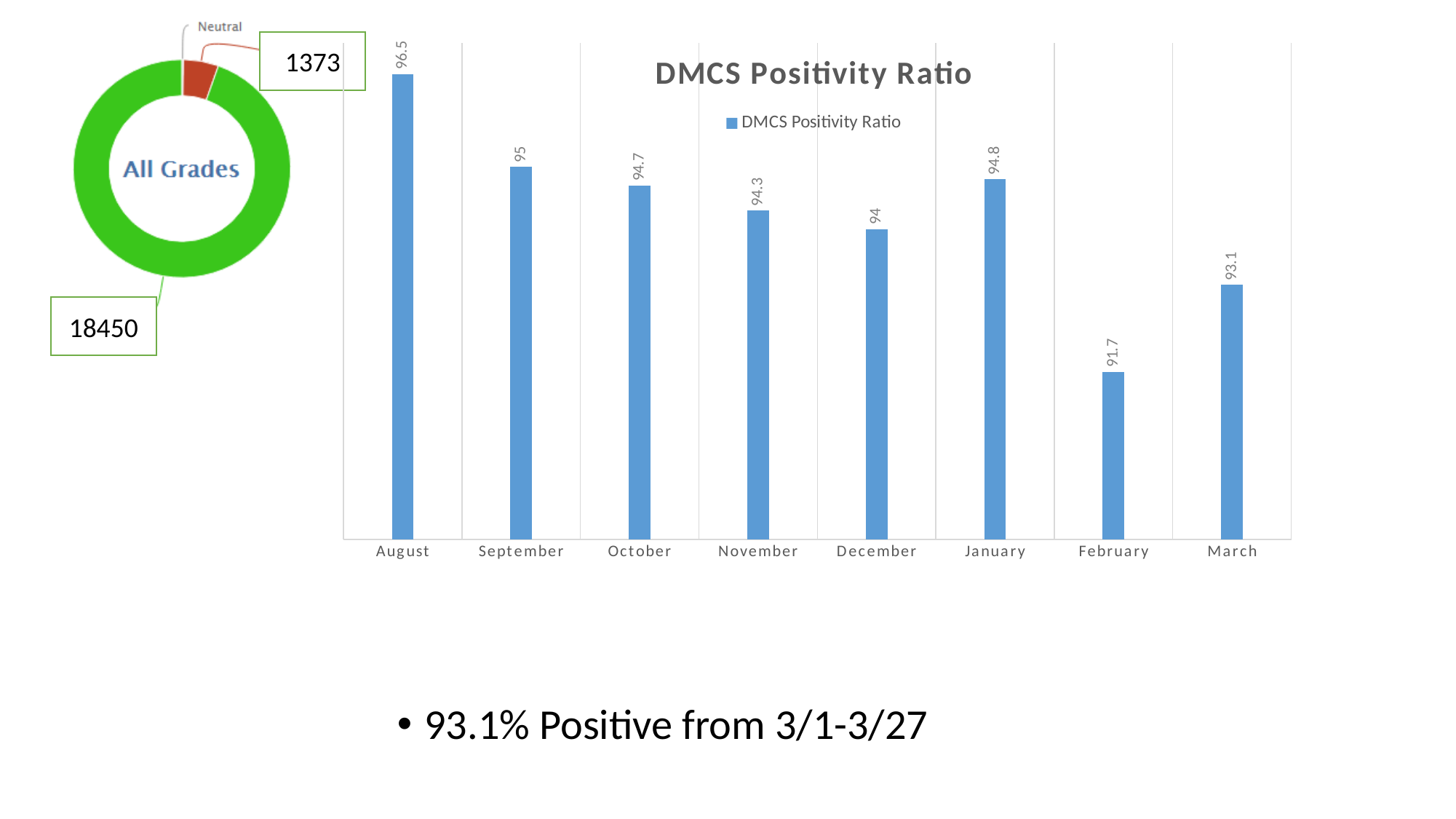
In the DMCS Positivity Ratio chart, which month has the lowest value? February In the DMCS Positivity Ratio chart, what is the value for January? 94.8 What kind of chart is the DMCS Positivity Ratio chart? Bar chart In the All Grades donut chart on the left, what value is labelled for the red Neutral slice? 1373 How many months are shown in the DMCS Positivity Ratio chart? 8 In the DMCS Positivity Ratio chart, what is the difference between the August value and the February value? 4.8 In the DMCS Positivity Ratio chart, which month has the highest value? August In the All Grades donut chart on the left, what value is labelled for the green slice? 18450 In the DMCS Positivity Ratio chart, which is larger, the value for October or the value for December? October In the DMCS Positivity Ratio chart, what is the value for February? 91.7 In the DMCS Positivity Ratio chart, what is the value for August? 96.5 How many series does the legend of the DMCS Positivity Ratio chart list? 1